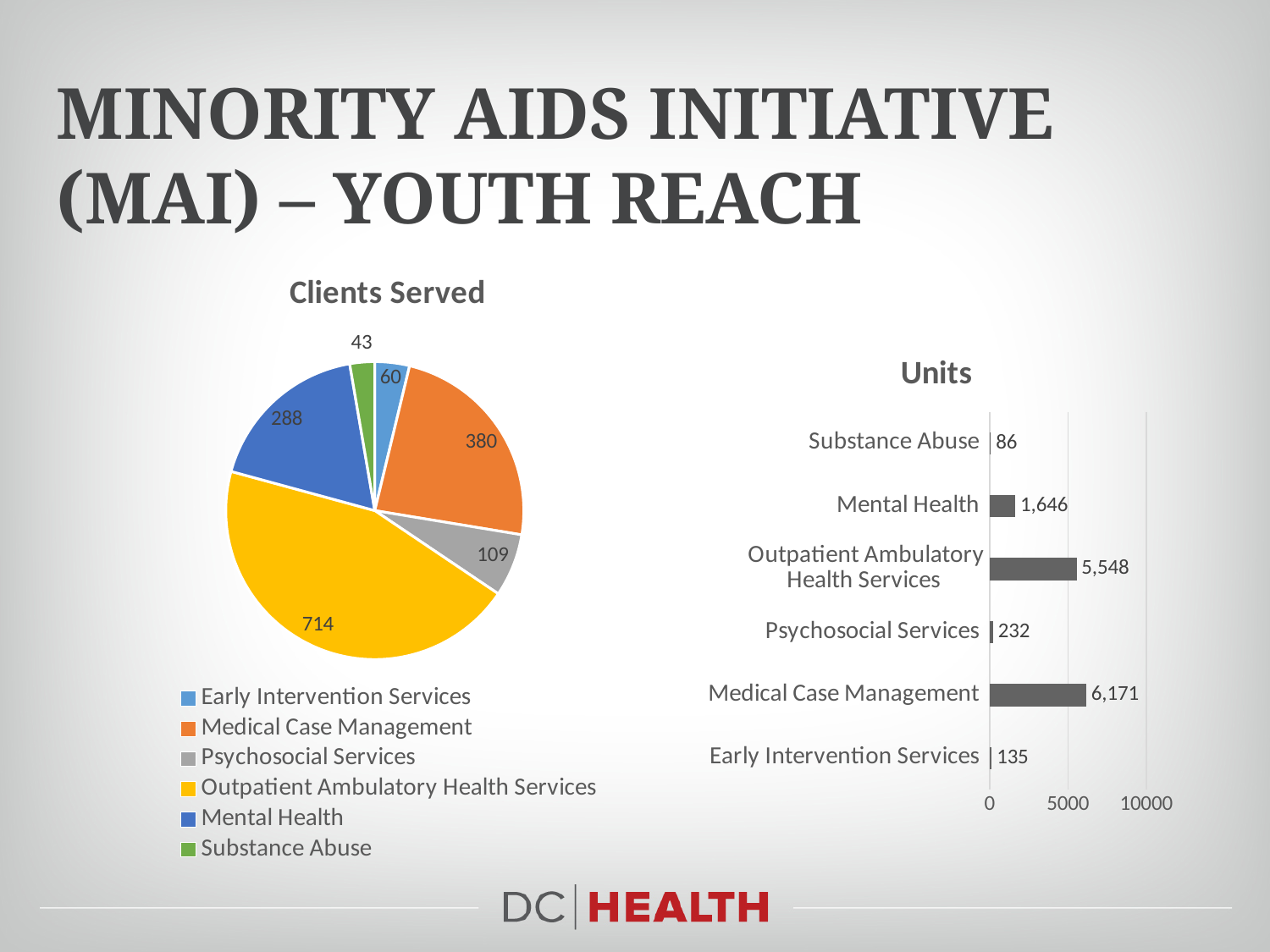
In the Clients Served pie chart, what is the difference between the Outpatient Ambulatory Health Services value and the Medical Case Management value? 334 In the Units chart, which category has the lowest value? Substance Abuse In the Clients Served pie chart, how many clients were served by Medical Case Management? 380 In the Units chart, how many units are shown for Mental Health? 1,646 In the Units chart, how many units are shown for Medical Case Management? 6,171 In the Units chart, what is the difference between Medical Case Management and Outpatient Ambulatory Health Services? 623 In the Units chart, which is larger: Psychosocial Services or Early Intervention Services? Psychosocial Services In the Clients Served pie chart, which category has the smallest slice? Substance Abuse What kind of chart is the Units chart? Bar chart How many categories does the legend of the Clients Served pie chart list? 6 In the Clients Served pie chart, which category has the largest slice? Outpatient Ambulatory Health Services In the Clients Served pie chart, how many clients were served by Outpatient Ambulatory Health Services? 714